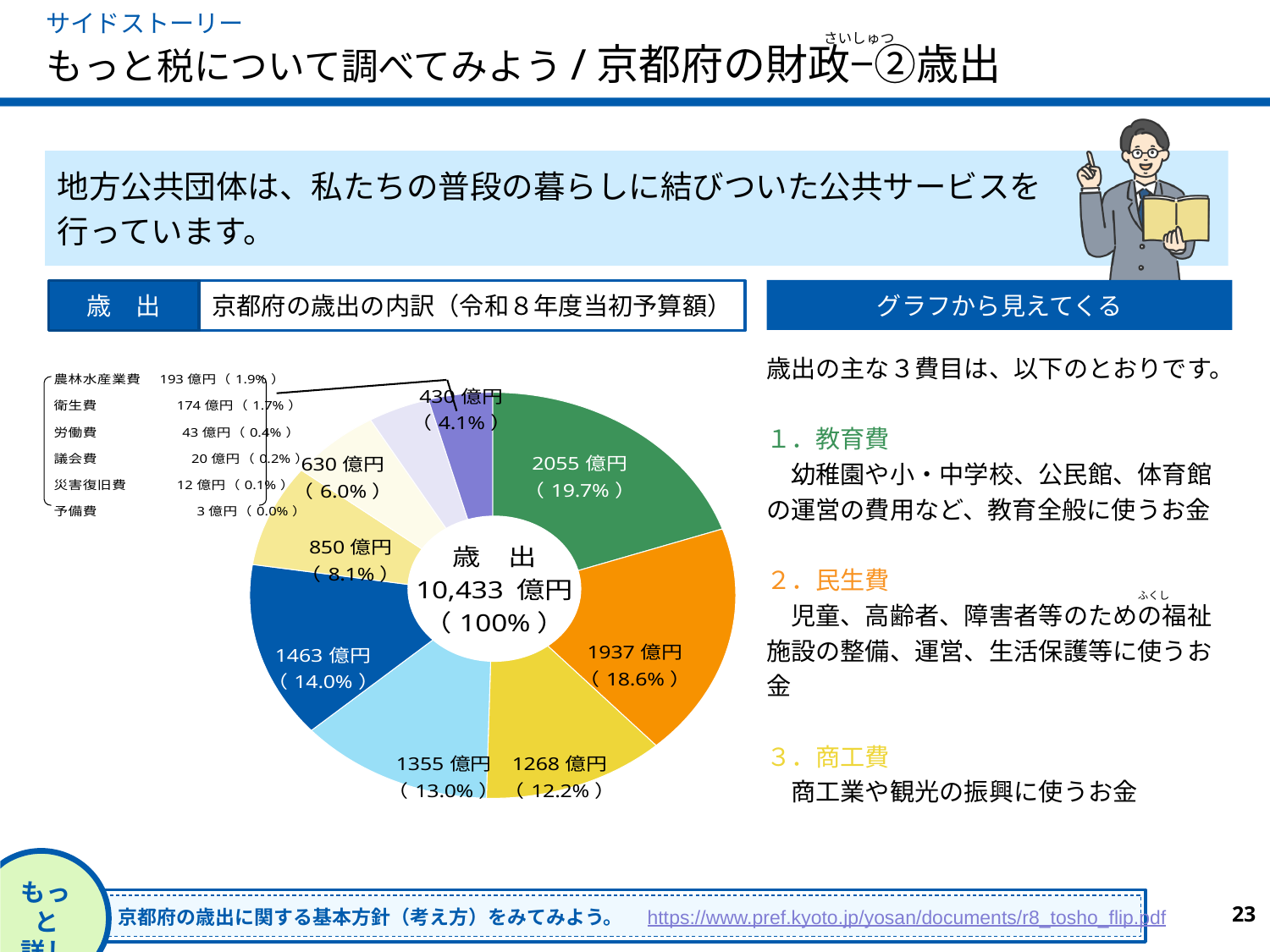
What is the value for 農林水産業費 in the pie chart? 193 億円 What percentage share does 衛生費 have in the pie chart? 1.7% Which is larger, 農林水産業費 or 衛生費? 農林水産業費 What is the value of the largest slice in the pie chart? 2055 億円 What kind of chart is shown on the slide? pie chart What is the value for 予備費 in the pie chart? 3 億円 What is the difference between the 2055 億円 slice and the 1937 億円 slice? 118 億円 What share of the total does the largest slice (2055 億円) represent? 19.7% What is the total expenditure (歳出) shown in the centre of the pie chart? 10,433 億円 Which labelled category has the smallest value in the pie chart? 予備費 What is the value for 労働費 in the pie chart? 43 億円 What is the title of the pie chart? 京都府の歳出の内訳（令和８年度当初予算額）